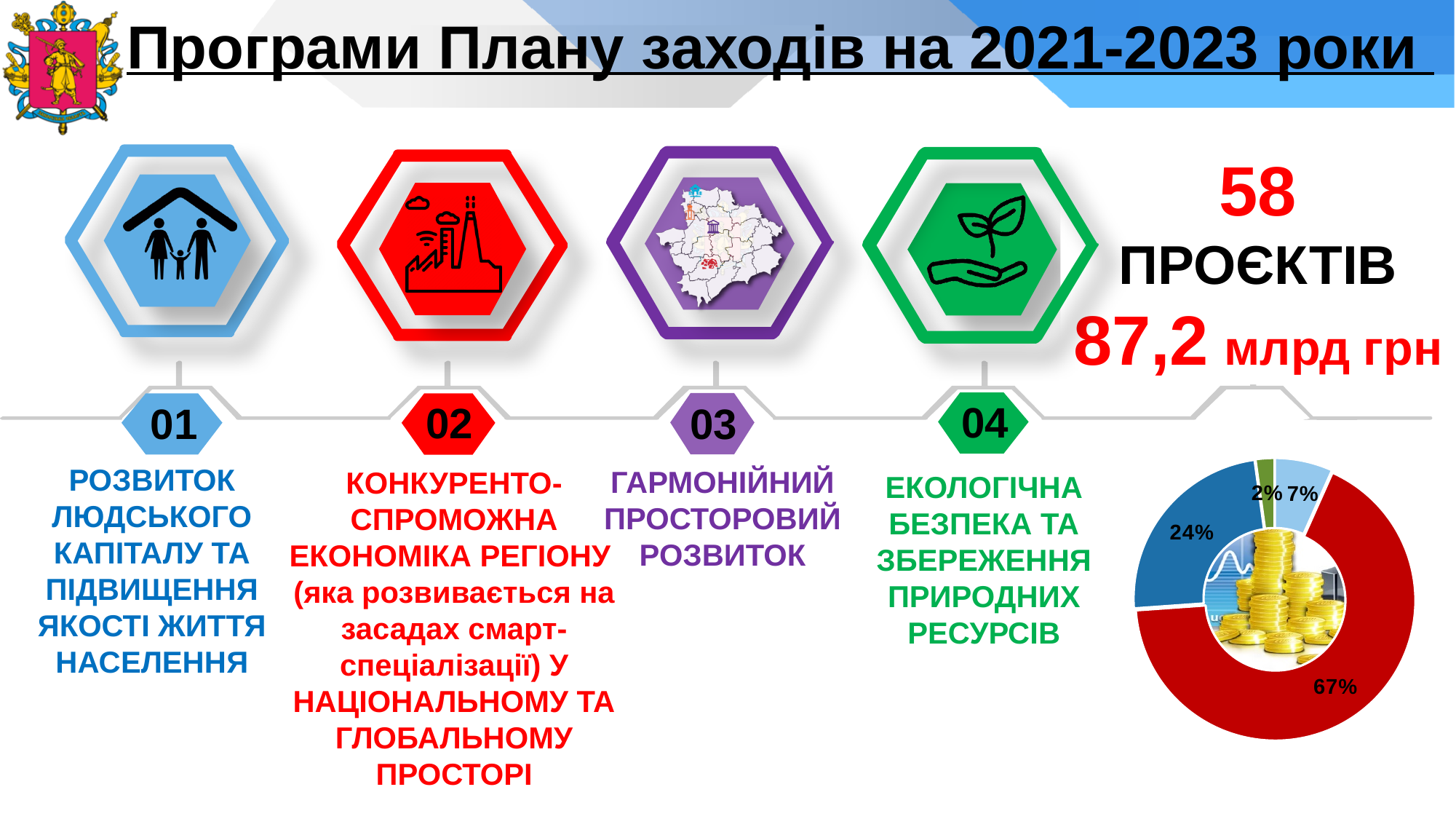
In the doughnut chart, what is the difference between the light blue slice and the green slice? 5% What percentage is shown on the light blue slice of the doughnut chart? 7% In the doughnut chart, what is the difference between the largest slice (67%) and the dark blue slice (24%)? 43% What is the value of the smallest slice in the doughnut chart? 2% What is the value of the largest slice in the doughnut chart? 67% What colour is the largest slice of the doughnut chart? Red What percentage is shown on the dark blue slice of the doughnut chart? 24% How many slices does the doughnut chart at the bottom right have? 4 What kind of chart is shown at the bottom right of the slide? Doughnut (pie) chart What percentage is shown on the red slice of the doughnut chart? 67% What percentage is shown on the green slice of the doughnut chart? 2% In the doughnut chart, which slice is larger: the light blue slice or the green slice? The light blue slice (7%)